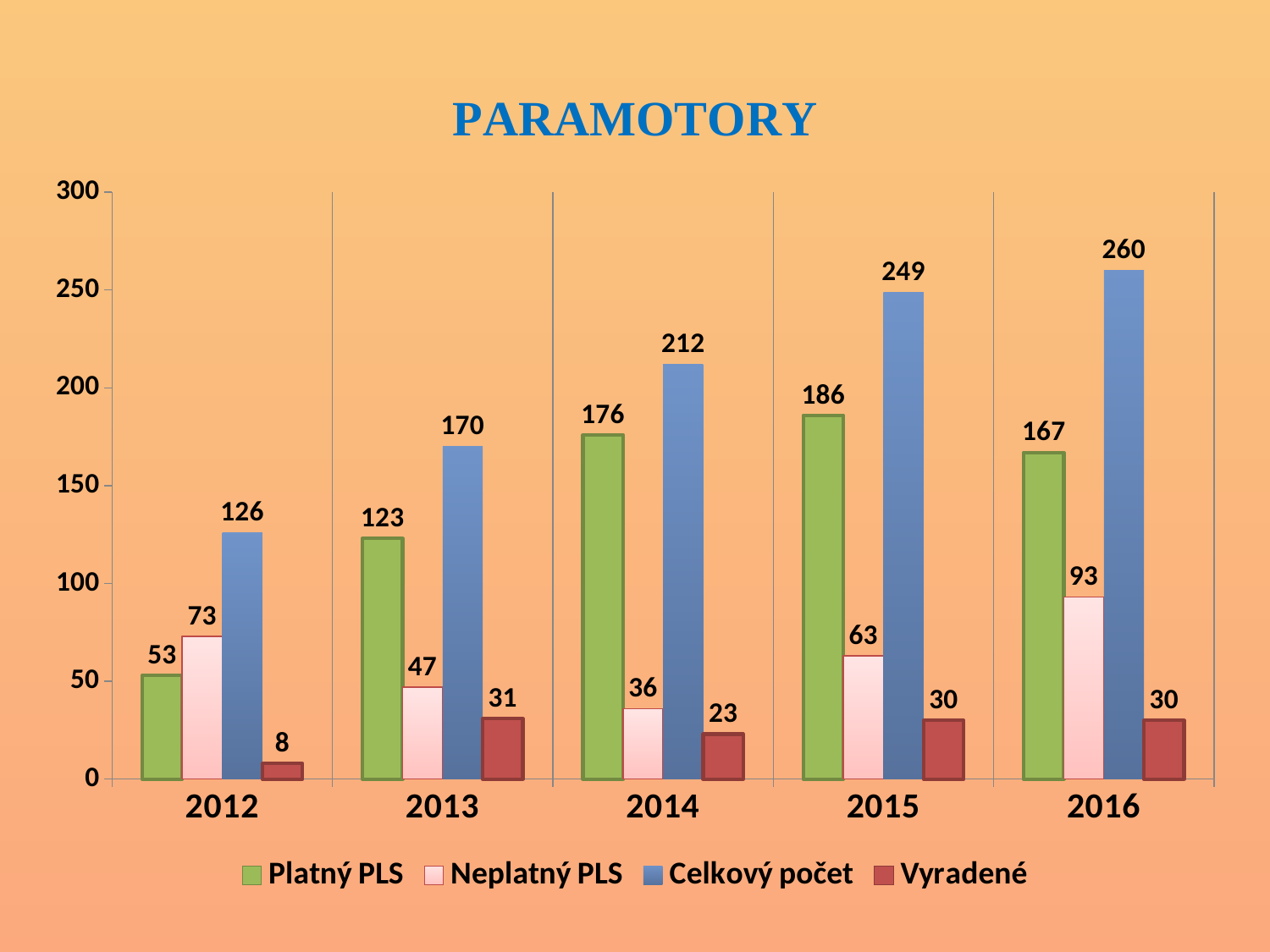
How many years are shown on the x axis? 5 What kind of chart is shown on the slide? Bar chart In which year is Neplatný PLS lowest? 2014 Which is larger in 2012: Platný PLS or Neplatný PLS? Neplatný PLS What is the value of Vyradené for 2012? 8 In which year is Platný PLS highest? 2015 Does Celkový počet rise or fall from 2012 to 2016? Rise What is the value of Celkový počet for 2016? 260 What is the difference between Celkový počet in 2016 and in 2012? 134 How many series does the legend list? 4 What is the value of Platný PLS for 2014? 176 What is the value of Neplatný PLS for 2013? 47